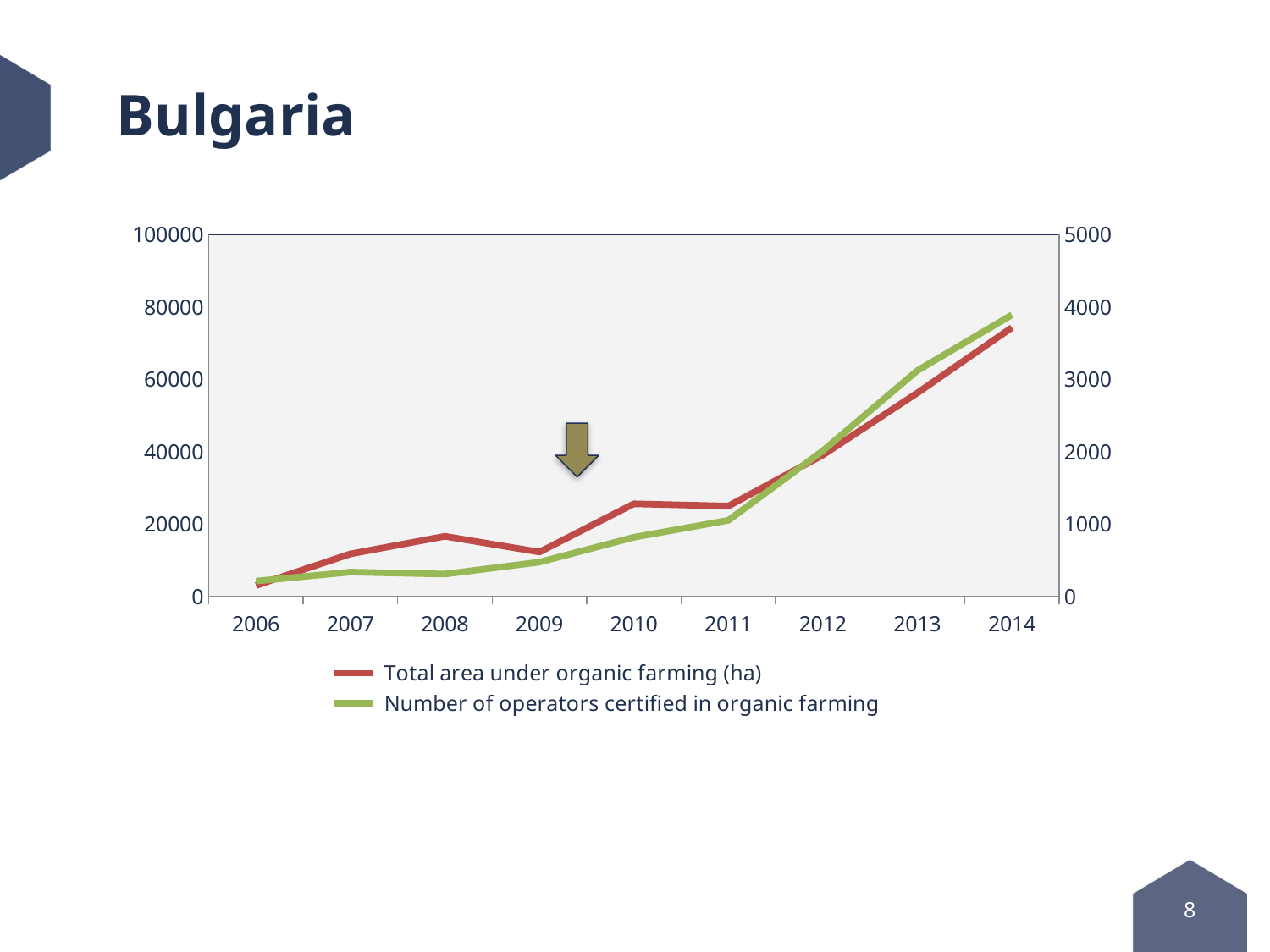
Is the number of operators certified in organic farming in 2008 greater or less than 1000 on the right axis? less How many years are plotted along the x axis? 9 Is the total area under organic farming (ha) in 2009 greater or less than 20000? less How many series does the legend list? 2 What kind of chart is shown on the slide? line chart In which year is the total area under organic farming (ha) highest? 2014 Does the number of operators certified in organic farming rise or fall from 2006 to 2014? rise Is the number of operators certified in organic farming in 2014 greater or less than 3000 on the right axis? greater In which year is the total area under organic farming (ha) lowest? 2006 Which colour is used for the 'Total area under organic farming (ha)' line? red Which year has the larger total area under organic farming (ha), 2008 or 2009? 2008